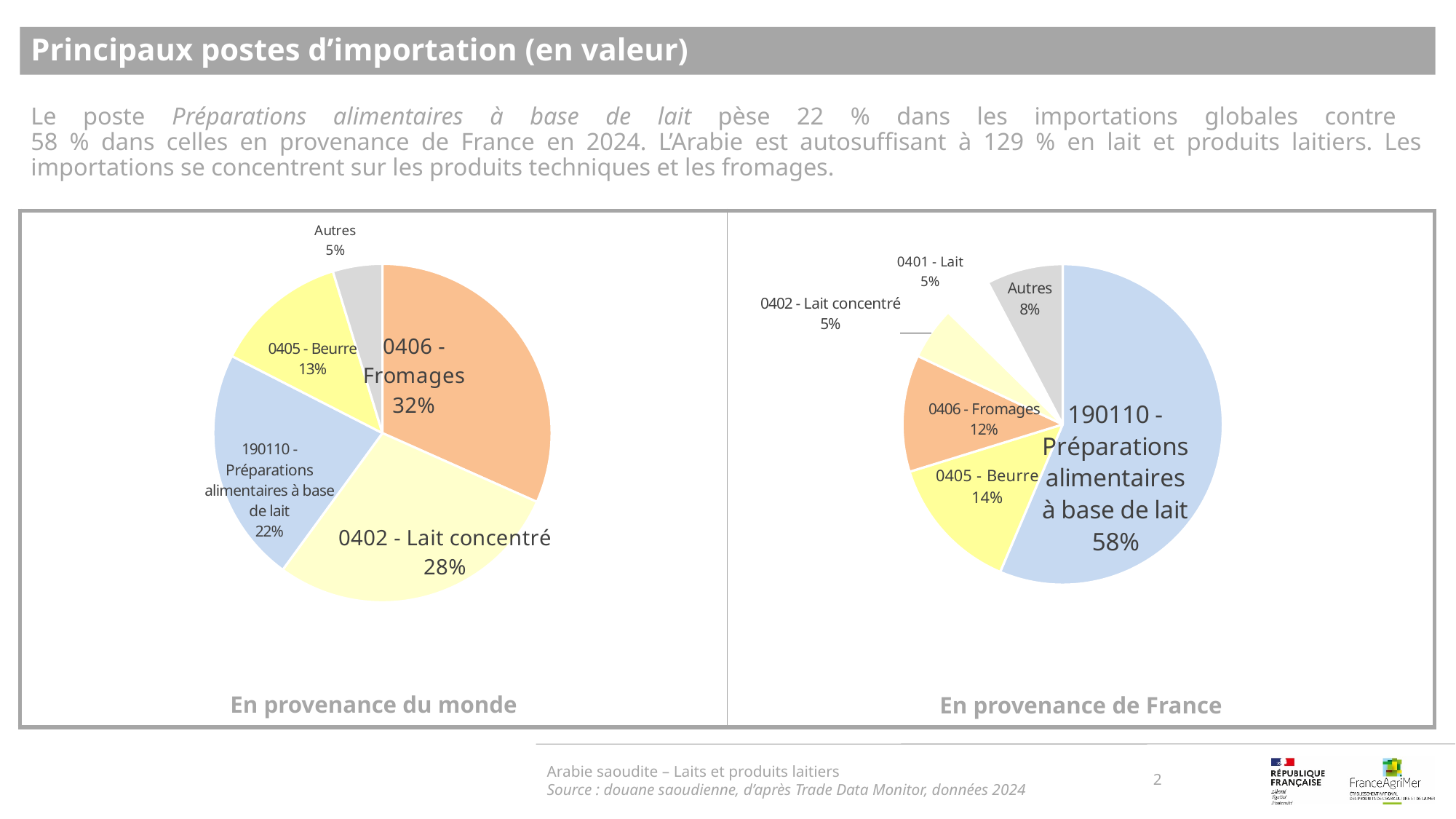
In the 'En provenance du monde' chart, what share does 0406 - Fromages hold? 32% In the 'En provenance de France' chart, what share does 0405 - Beurre hold? 14% In the 'En provenance du monde' chart, which category has the largest share? 0406 - Fromages In the 'En provenance du monde' chart, what is the difference between the shares of 0406 - Fromages and 0405 - Beurre? 19% In the 'En provenance du monde' chart, what share does 0402 - Lait concentré hold? 28% In the 'En provenance du monde' chart, which category has the smallest share? Autres In the 'En provenance de France' chart, what is the difference between the shares of 190110 - Préparations alimentaires à base de lait and 0406 - Fromages? 46% How many slices does the 'En provenance de France' pie chart have? 6 What type of chart is used in the 'En provenance du monde' panel? Pie chart In the 'En provenance de France' chart, what share does 190110 - Préparations alimentaires à base de lait hold? 58% How many slices does the 'En provenance du monde' pie chart have? 5 In the 'En provenance de France' chart, which is larger: 0406 - Fromages or Autres? 0406 - Fromages